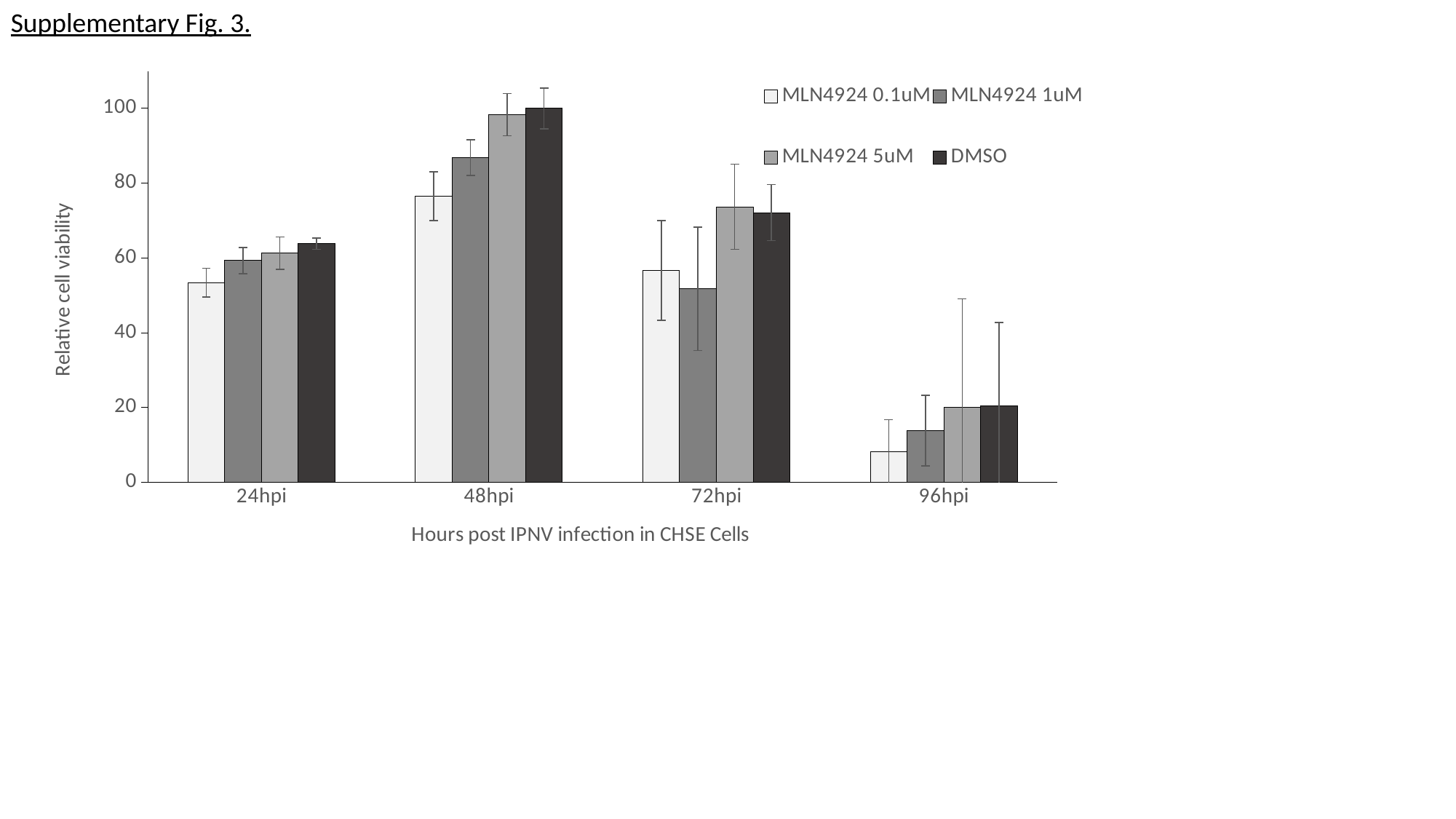
At which time point is the MLN4924 0.1uM value lowest? 96hpi How many series does the legend list? 4 Is the value for MLN4924 0.1uM at 24hpi greater or less than 60? less At 48hpi, which is larger: MLN4924 0.1uM or MLN4924 5uM? MLN4924 5uM Is the value for MLN4924 0.1uM at 96hpi greater or less than 20? less What is the relative cell viability for DMSO at 48hpi? 100 What kind of chart is shown on the slide? bar chart Is the value for DMSO at 72hpi greater or less than 60? greater At which time point is the DMSO value highest? 48hpi How many time-point categories are shown on the x axis? 4 What is the title of the x axis? Hours post IPNV infection in CHSE Cells